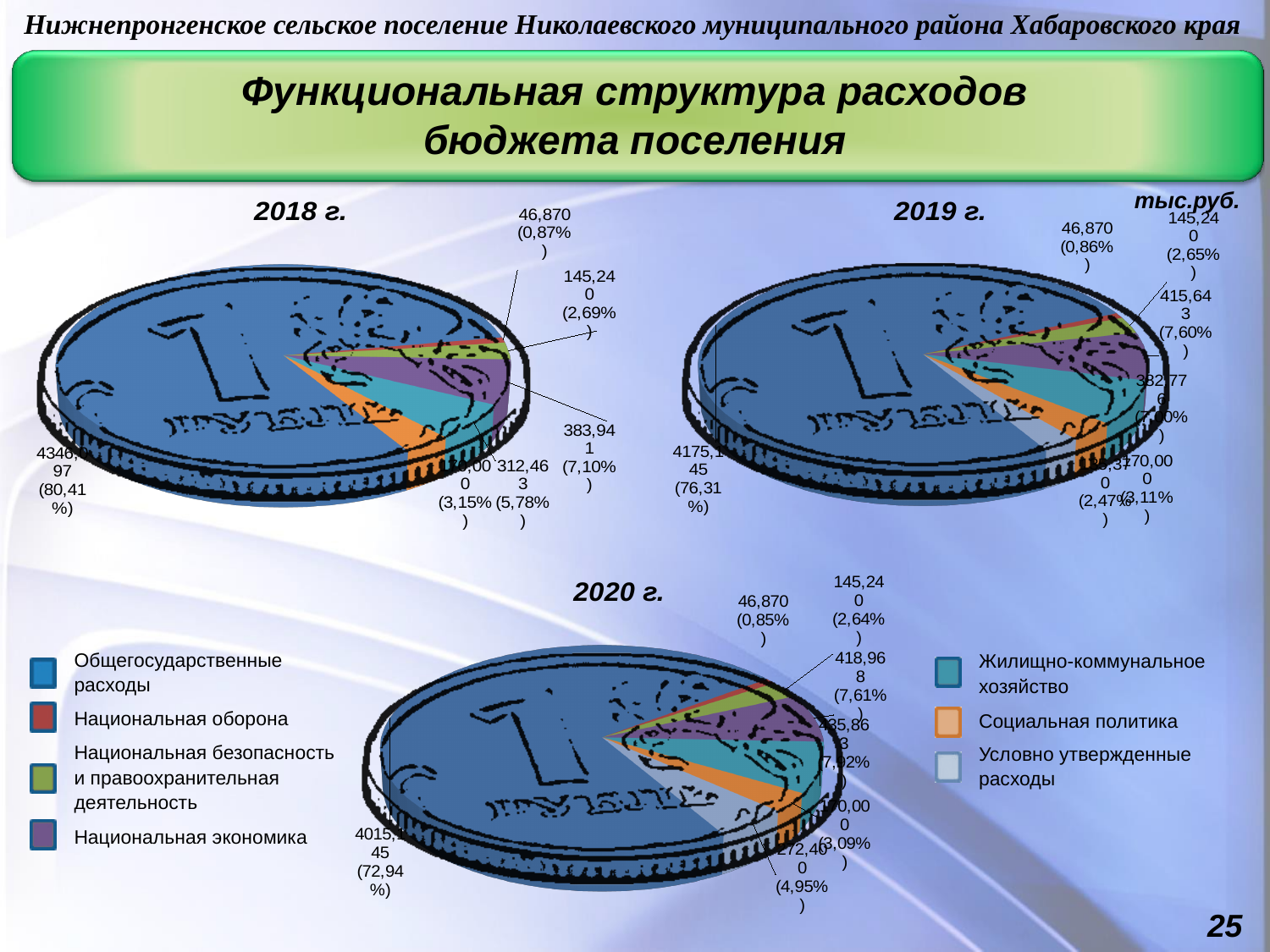
In the 2018 г. chart, what share of the pie is Национальная оборона? 0,87% In the 2020 г. chart, what is the value for Социальная политика (orange slice)? 170,000 In the 2018 г. chart, what is the value for Национальная оборона (red slice)? 46,870 In the 2019 г. chart, what is the value for Национальная экономика (purple slice)? 415,643 How many categories does the legend list? 7 In the 2020 г. chart, which category has the largest slice? Общегосударственные расходы In the 2019 г. chart, which is larger: Национальная экономика or Жилищно-коммунальное хозяйство? Национальная экономика What kind of charts are shown on the slide? Pie charts What unit of measurement is indicated for the charts? тыс.руб. In the 2019 г. chart, which category has the smallest slice? Национальная оборона In the 2020 г. chart, what share of the pie is Общегосударственные расходы? 72,94%